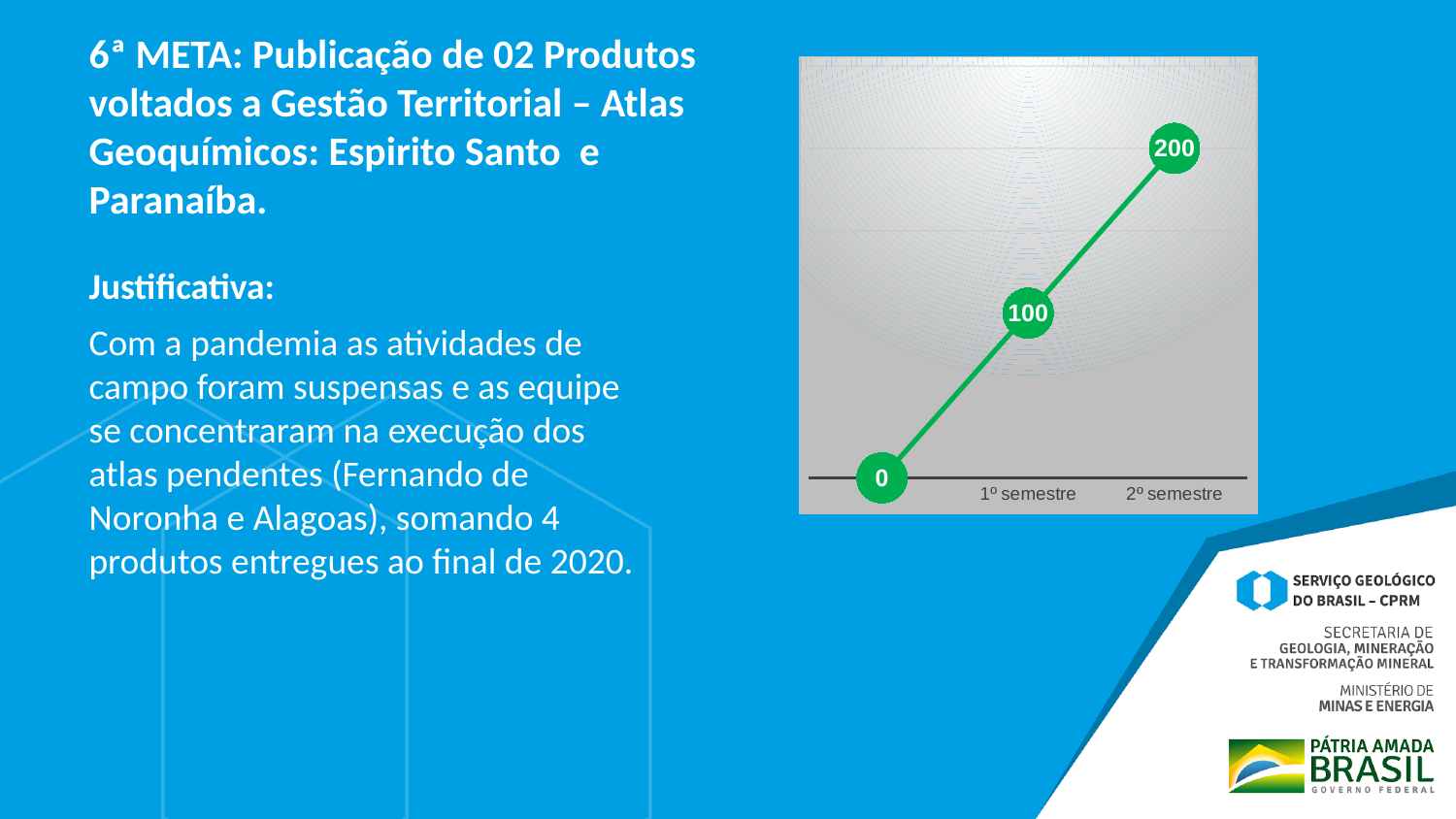
What is the difference between the value for 1º semestre and the first point on the line? 100 Do the values rise or fall from left to right along the x axis? rise What colour is the line in the chart? green What is the value plotted for 1º semestre? 100 What is the value of the first (leftmost) point on the line? 0 Which is larger, the value for 1º semestre or the value for 2º semestre? 2º semestre What is the difference between the values for 2º semestre and 1º semestre? 100 How many data points are plotted on the line? 3 What is the lowest value shown on the line? 0 Which labelled semester has the highest value? 2º semestre What kind of chart is shown on the slide? line chart What is the value plotted for 2º semestre? 200